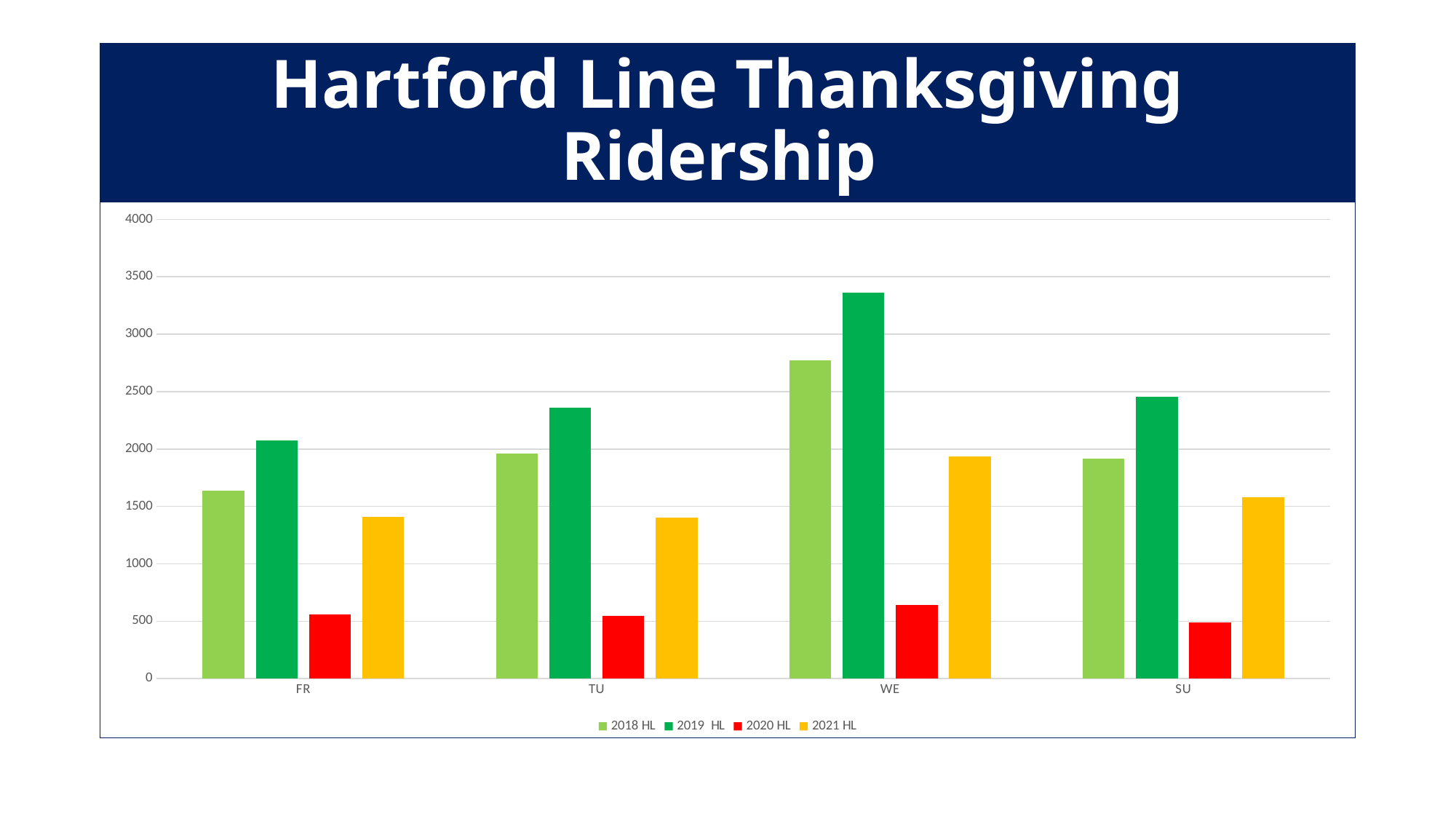
What colour are the 2020 HL bars? red What is the title of the chart? Hartford Line Thanksgiving Ridership How many series does the legend list? 4 How many day categories are shown on the x axis? 4 Which is larger: the 2019 HL value for FR or the 2018 HL value for WE? 2018 HL value for WE Is the 2019 HL value for WE greater or less than 3000? greater Which series has the lowest value for WE? 2020 HL Which day has the highest 2019 HL ridership? WE Is the 2021 HL value for SU greater or less than 1500? greater Is the 2020 HL value for FR greater or less than 1000? less What kind of chart is shown on the slide? bar chart Which is larger: the 2021 HL value for WE or the 2021 HL value for FR? WE